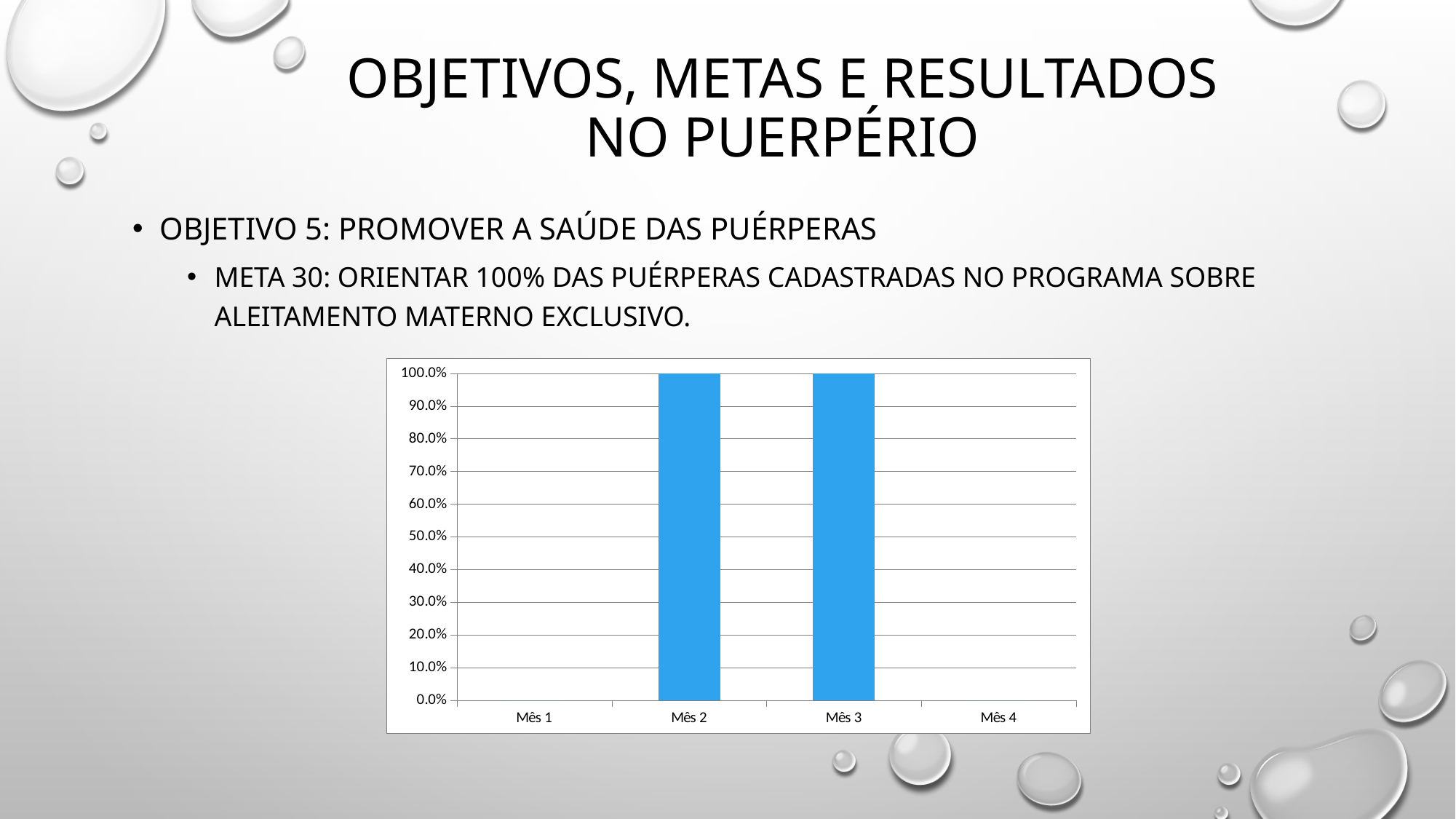
Which of Mês 3 and Mês 4 has the larger value in the chart? Mês 3 Which categories in the chart have no visible bar? Mês 1 and Mês 4 What kind of chart is shown on the slide? bar chart Is the value for Mês 2 greater or less than 50.0%? greater Which of Mês 1 and Mês 2 has the larger value in the chart? Mês 2 What is the highest value shown on the vertical axis of the chart? 100.0% What is the value for Mês 3 in the chart? 100.0% What is the difference between the values for Mês 2 and Mês 3? 0.0% Is the value for Mês 3 greater or less than 90.0%? greater How many categories are shown on the x axis of the chart? 4 What is the value for Mês 2 in the chart? 100.0% What is the label of the first category on the x axis? Mês 1